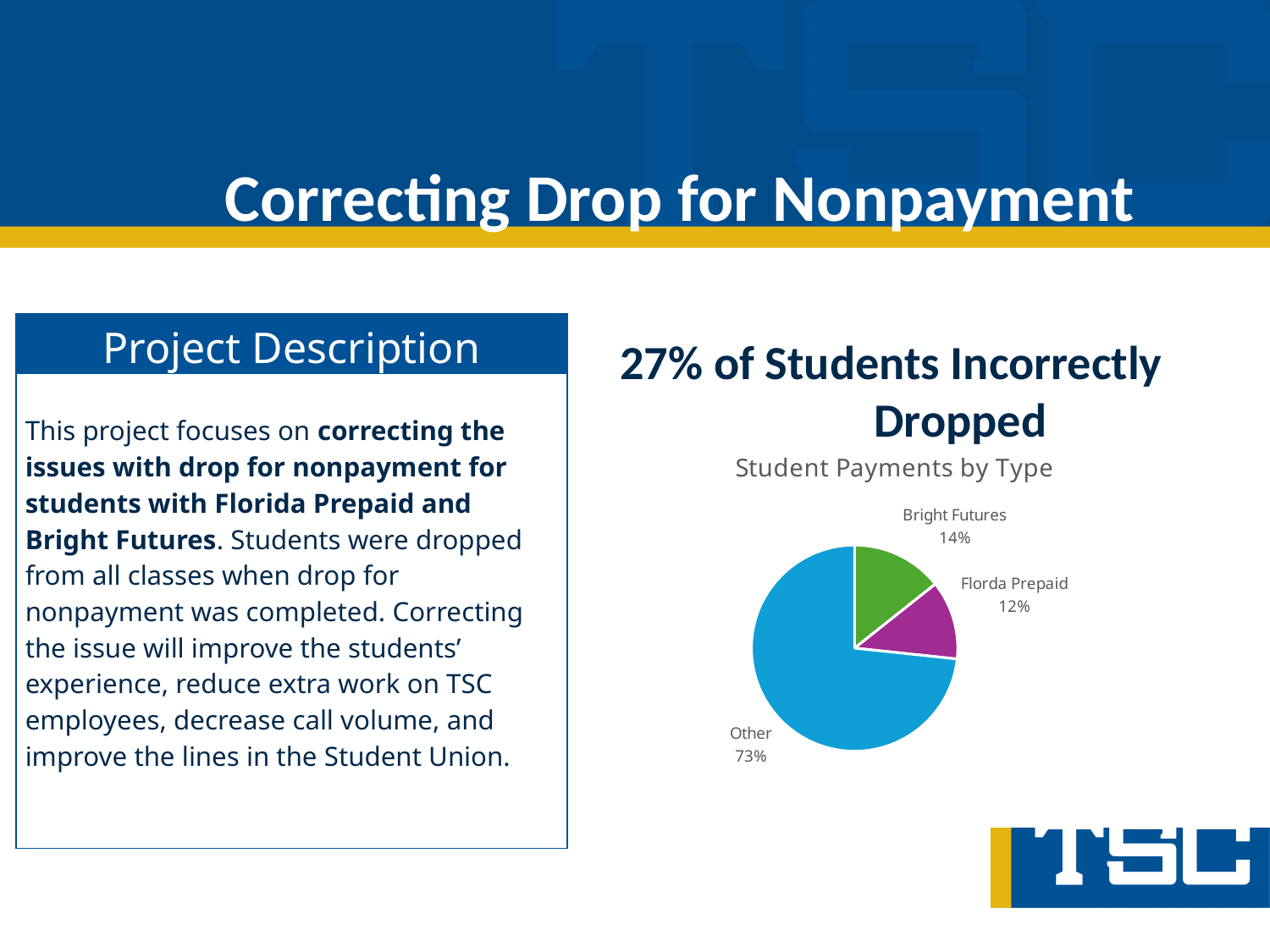
What percentage of student payments is Other? 73% What kind of chart is shown on the slide? pie chart What percentage of student payments is Bright Futures? 14% What colour is the Other slice of the pie chart? blue Which payment type has the smallest share of the pie? Florda Prepaid What is the difference in percentage points between the Other slice and the Bright Futures slice? 59 Which payment type has the largest share of the pie? Other What is the combined share of the Bright Futures and Florda Prepaid slices? 26% How many slices does the pie chart have? 3 What percentage of student payments is Florda Prepaid? 12% What is the title of the chart? Student Payments by Type Which is larger, the Bright Futures slice or the Florda Prepaid slice? Bright Futures